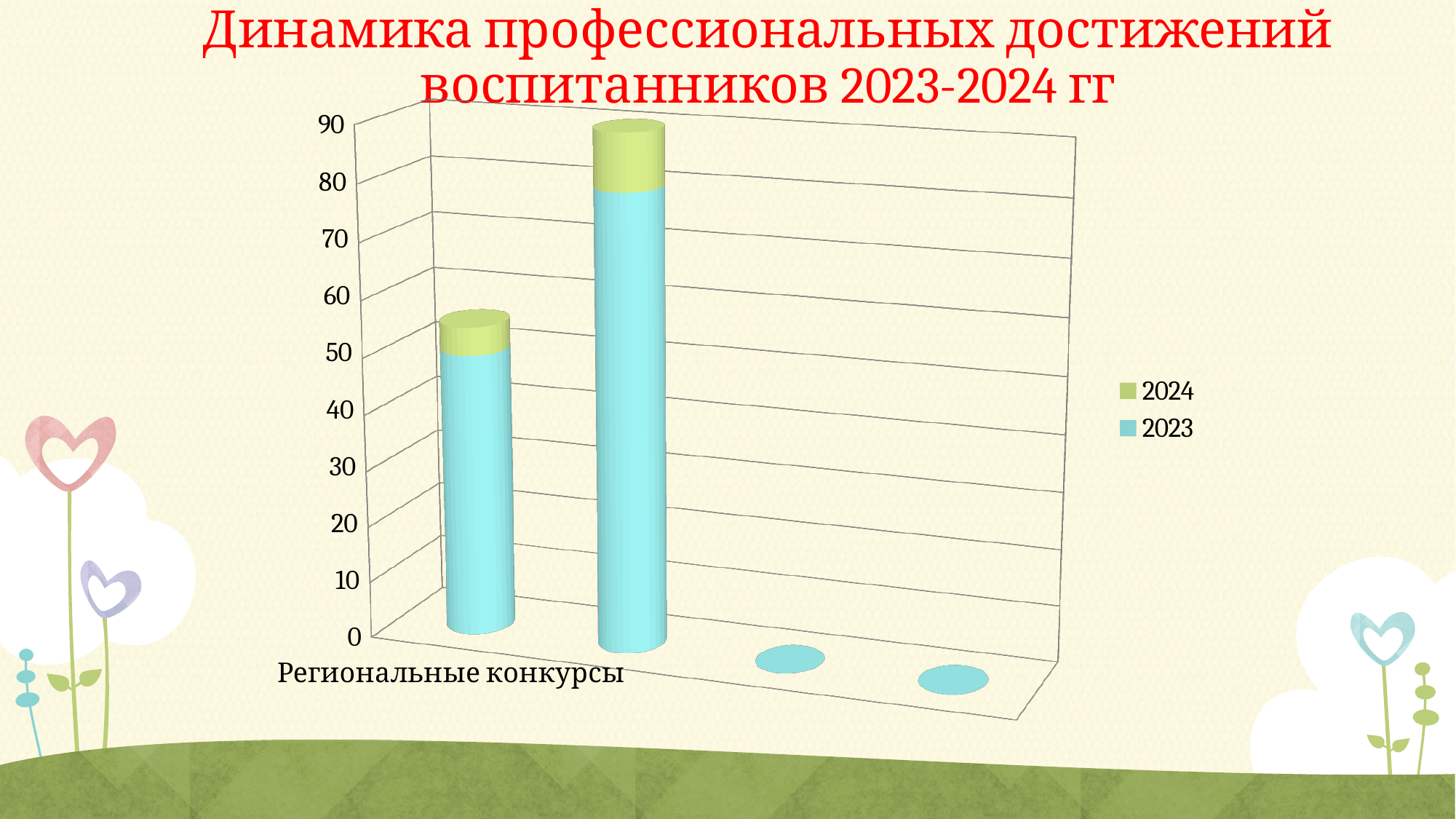
Is the total stacked value for Региональные конкурсы greater or less than 50? greater What is the highest value shown on the vertical axis? 90 Is the 2023 value for Региональные конкурсы greater or less than 60? less For Региональные конкурсы, which series contributes the larger part of the bar, 2023 or 2024? 2023 What are the two series named in the legend? 2024 and 2023 Which colour represents the 2023 series? Blue How many categories have bars rising above zero? 2 Is the 2023 value for Региональные конкурсы greater or less than 40? greater What kind of chart is shown on the slide? Bar chart How many series does the legend list? 2